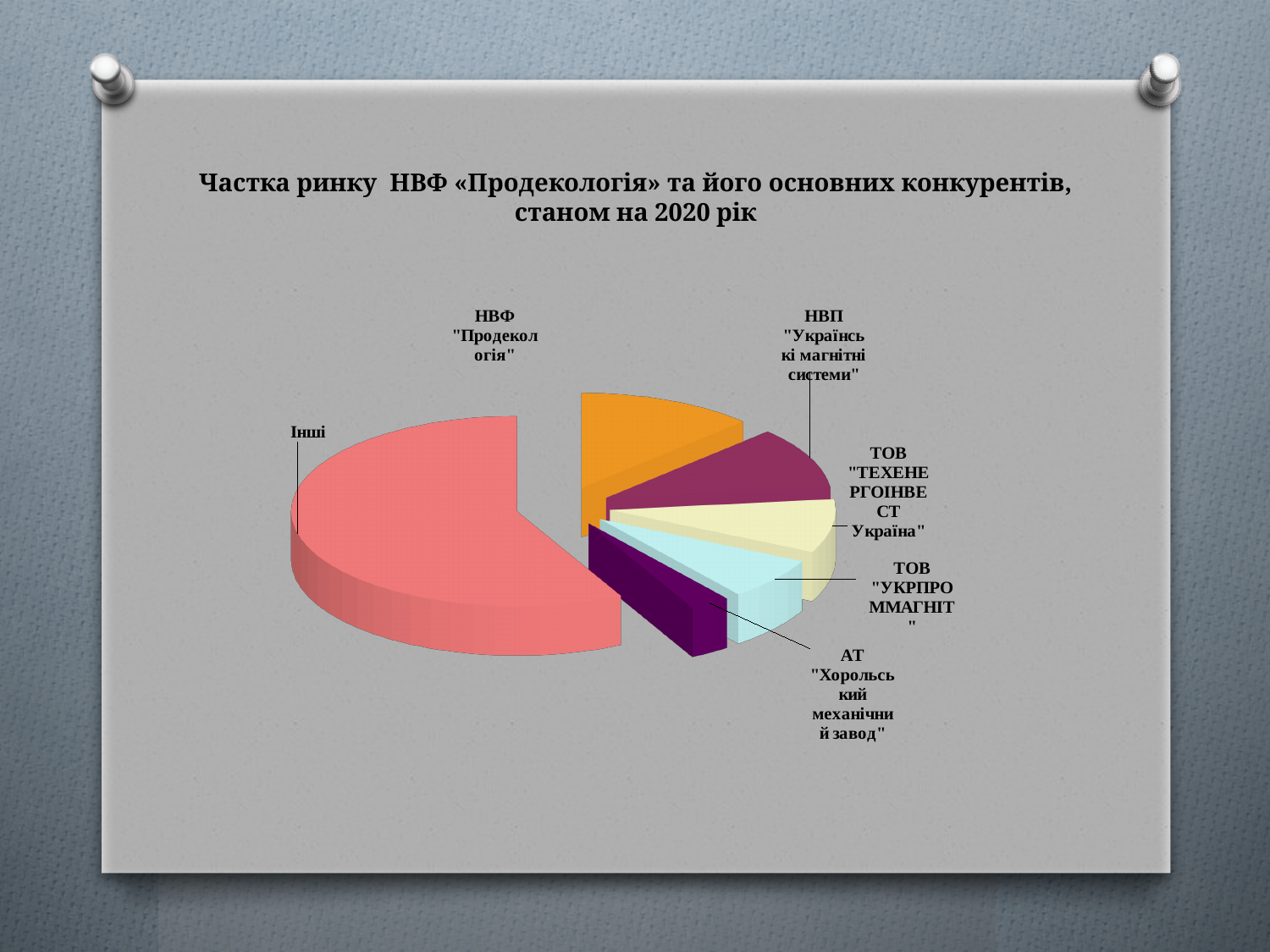
Which has a larger share: НВФ "Продекологія" or ТОВ "УКРПРОММАГНІТ"? НВФ "Продекологія" What is the title of the chart? Частка ринку НВФ «Продекологія» та його основних конкурентів, станом на 2020 рік What kind of chart is shown on the slide? Pie chart What colour is the slice for Інші? Pink How many slices does the pie chart have? 6 Which category has the smallest share of the pie? АТ "Хорольський механічний завод" Which has a larger share: Інші or ТОВ "ТЕХЕНЕРГОІНВЕСТ Україна"? Інші Which category has the largest share of the pie? Інші Which has a larger share: НВП "Українські магнітні системи" or АТ "Хорольський механічний завод"? НВП "Українські магнітні системи"